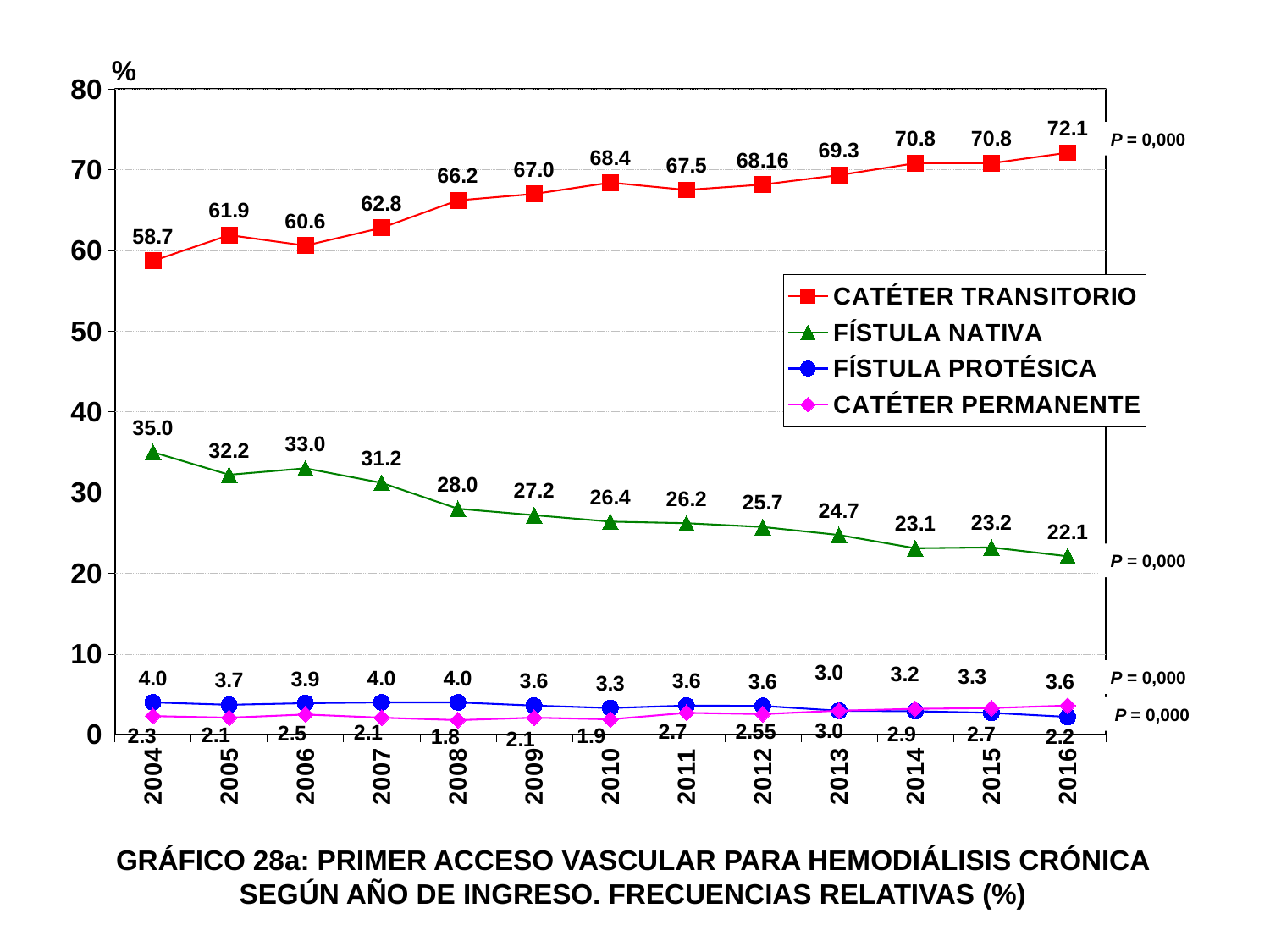
How many years are plotted along the x axis? 13 What is the value for CATÉTER TRANSITORIO in 2012? 68.16 In which year is FÍSTULA NATIVA lowest? 2016 What is the value for FÍSTULA NATIVA in 2016? 22.1 What colour is the line for FÍSTULA NATIVA? Green Does the FÍSTULA NATIVA series generally rise or fall from 2004 to 2016? Fall What kind of chart is shown on the slide? Line chart How many series does the legend list? 4 What is the difference between the CATÉTER TRANSITORIO value in 2016 and in 2004? 13.4 What is the value for CATÉTER TRANSITORIO in 2004? 58.7 Which is larger in 2008: FÍSTULA NATIVA or CATÉTER TRANSITORIO? CATÉTER TRANSITORIO In which year is CATÉTER TRANSITORIO highest? 2016